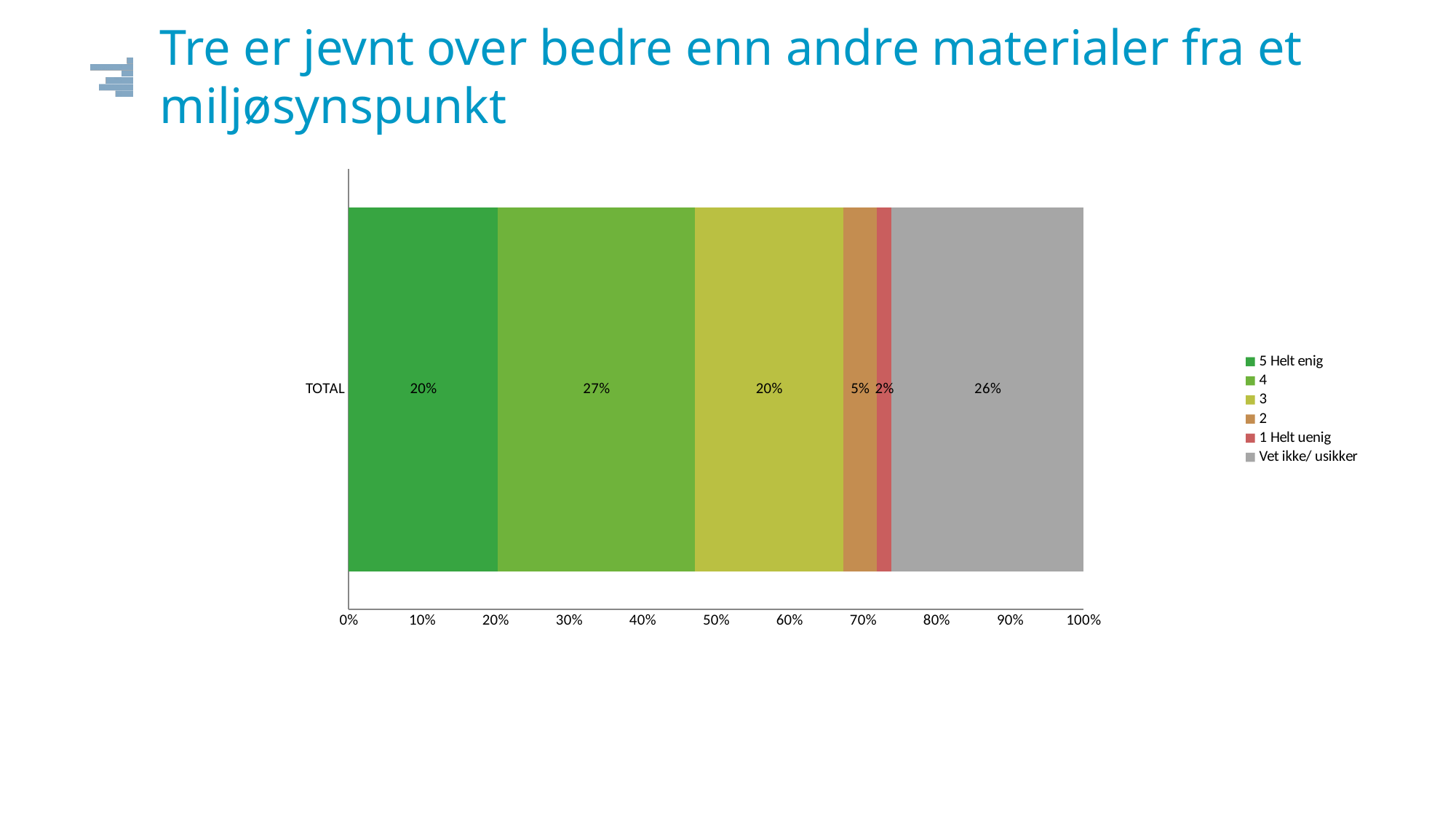
What kind of chart is shown on the slide? Stacked bar chart What percentage of respondents answered "Vet ikke/ usikker" for TOTAL? 26% Which response category has the smallest share in the TOTAL bar? 1 Helt uenig What percentage of respondents answered "5 Helt enig" for TOTAL? 20% What percentage of respondents answered "1 Helt uenig" for TOTAL? 2% What percentage of respondents answered "4" for TOTAL? 27% What is the combined share of "5 Helt enig" and "4"? 47% Which is larger, the share for "Vet ikke/ usikker" or the share for "3"? Vet ikke/ usikker How many series does the legend list? 6 What is the difference between the share for "4" and the share for "2"? 22% What percentage of respondents answered "2" for TOTAL? 5% Which response category has the largest share in the TOTAL bar? 4